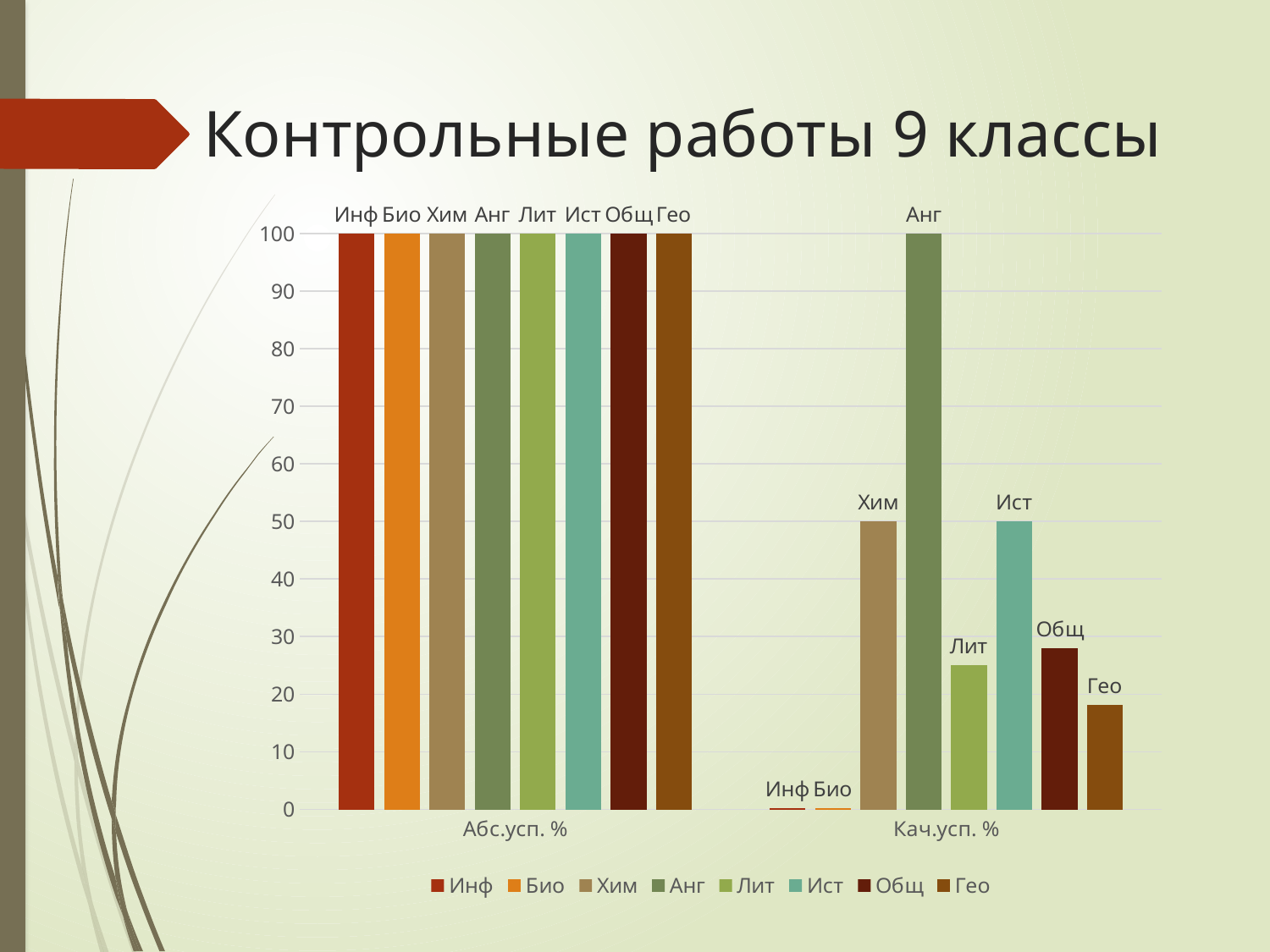
Is the value for Лит in the Кач.усп. % category greater or less than 30? less What is the value for Анг in the Кач.усп. % category? 100 How many series does the legend list? 8 What is the title of the slide? Контрольные работы 9 классы What kind of chart is shown on the slide? bar chart What is the value for Хим in the Кач.усп. % category? 50 What is the value for Гео in the Абс.усп. % category? 100 What is the value for Ист in the Кач.усп. % category? 50 In the Кач.усп. % category, which is larger, Общ or Гео? Общ Is the value for Гео in the Кач.усп. % category greater or less than 20? less How many categories are shown on the x axis? 2 Which series has the highest value in the Кач.усп. % category? Анг